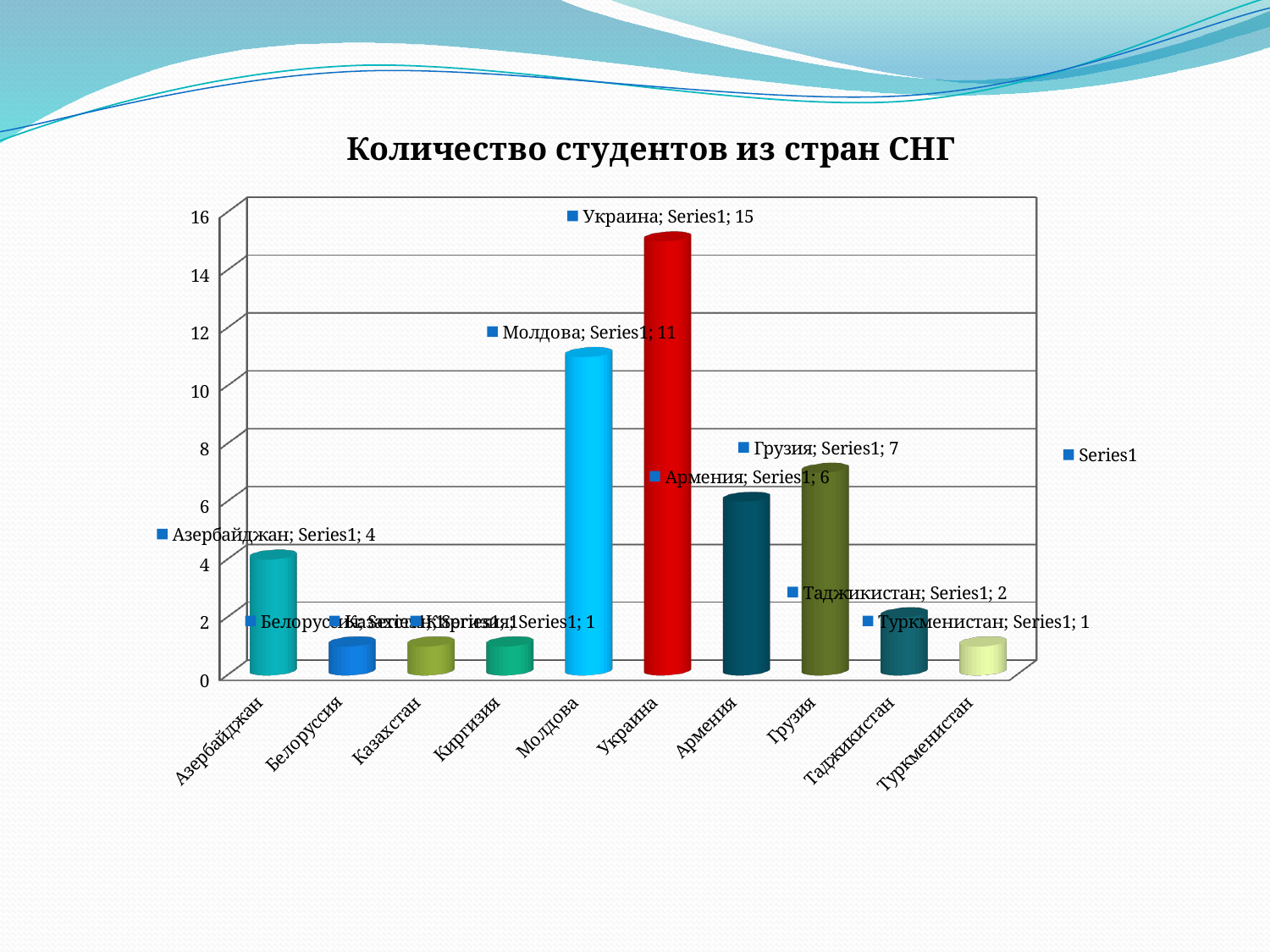
What is the title of the chart? Количество студентов из стран СНГ Is the value for Таджикистан greater or less than 4? less How many countries are shown on the x axis? 10 What is the value for Украина? 15 How many series does the legend list? 1 What kind of chart is shown? bar chart What is the value for Грузия? 7 Which country has the highest value? Украина Which is larger, the value for Армения or the value for Грузия? Грузия What is the value for Молдова? 11 What is the difference between the values for Украина and Молдова? 4 What is the value for Азербайджан? 4